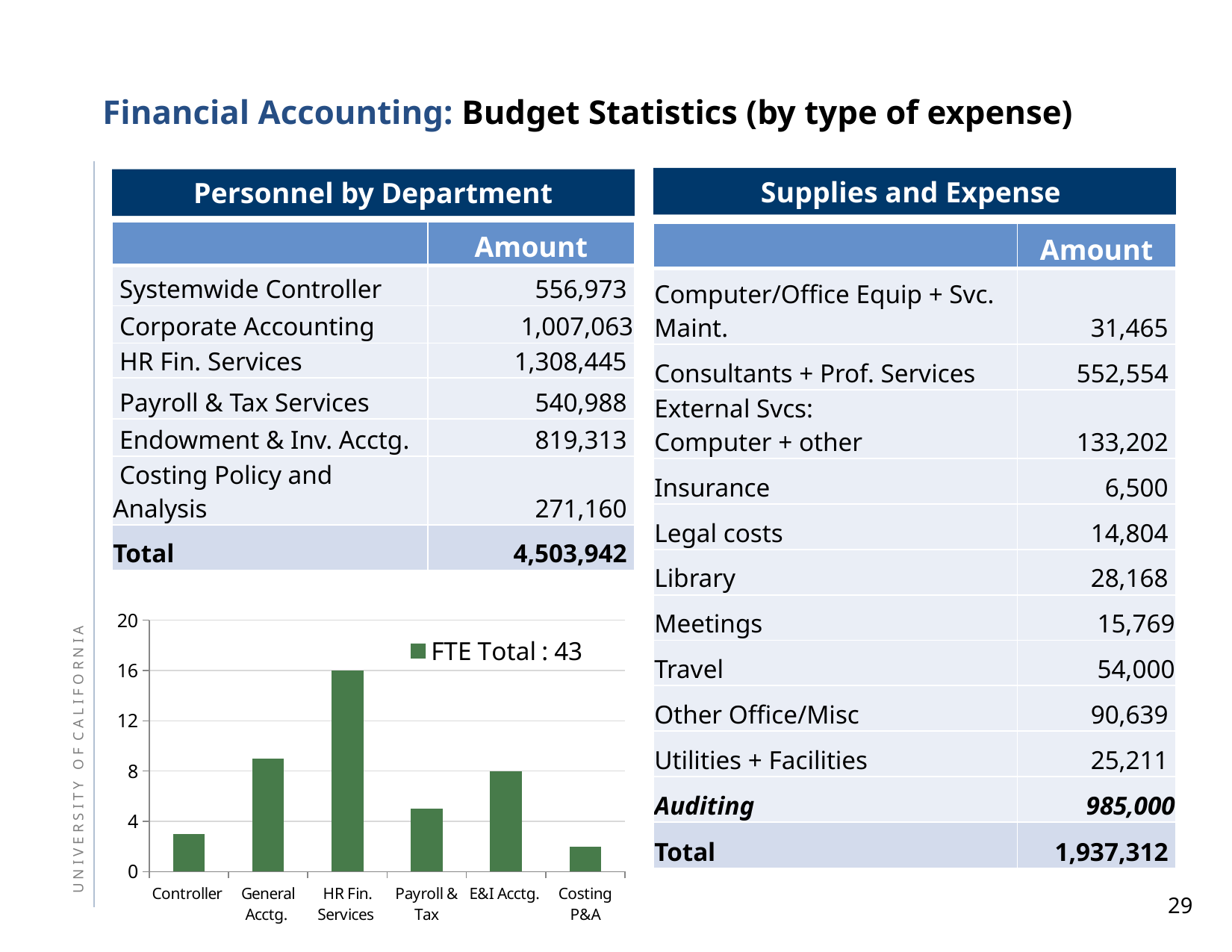
Which has the larger bar, General Acctg. or Payroll & Tax? General Acctg. What kind of chart is shown on the slide? bar chart How many series does the legend of the bar chart list? 1 What is the value for HR Fin. Services in the bar chart? 16 Which category has the lowest bar in the chart? Costing P&A Is the value for General Acctg. greater or less than 8? greater What is the difference between the values for HR Fin. Services and E&I Acctg. in the bar chart? 8 What is the value for E&I Acctg. in the bar chart? 8 Is the value for Controller greater or less than 4? less What is the legend entry shown in the bar chart? FTE Total : 43 How many categories are plotted on the x axis of the bar chart? 6 Which category has the highest bar in the chart? HR Fin. Services